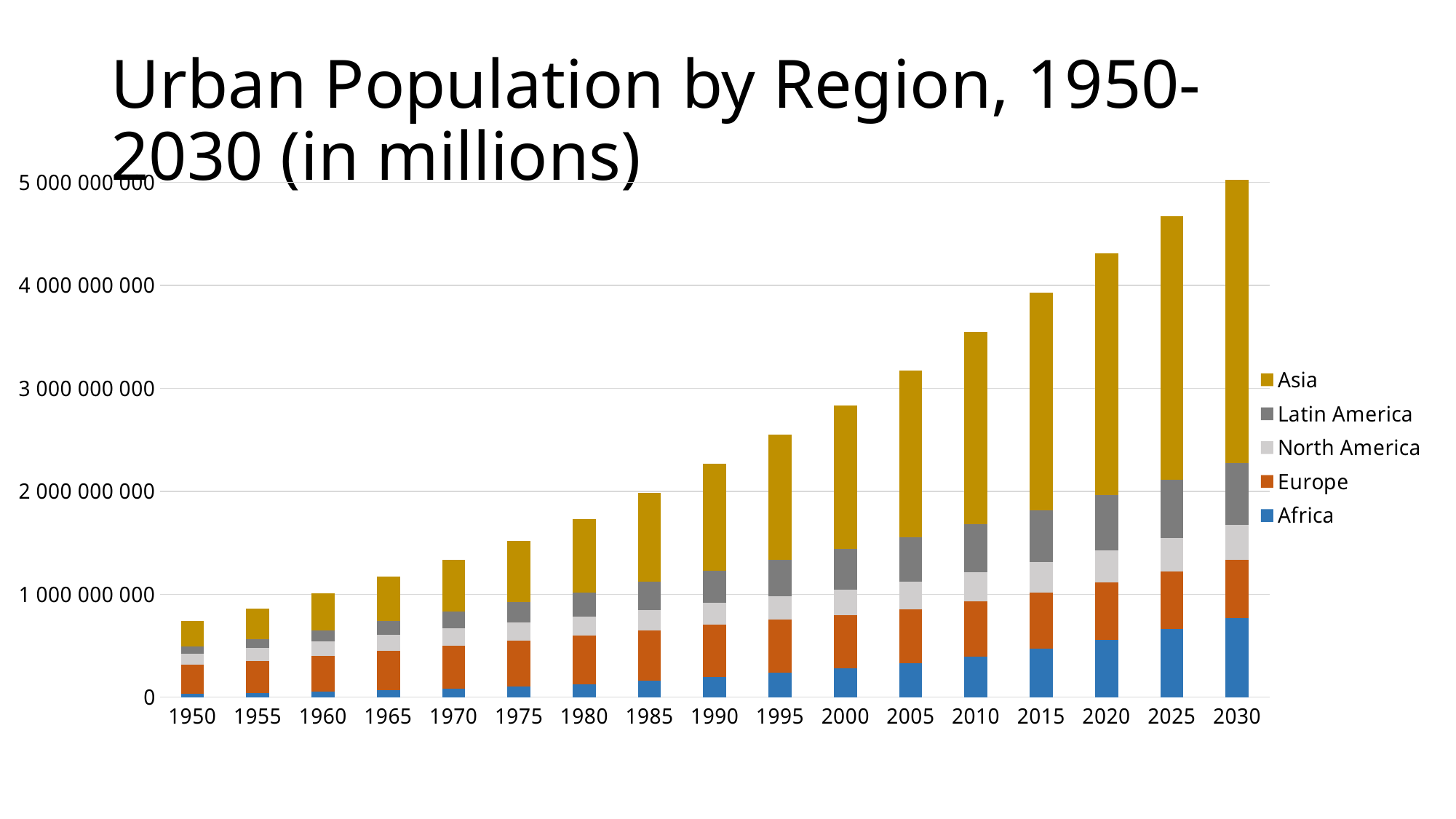
Is the total urban population for 1990 greater or less than 2 000 000 000? greater Which year has the lowest total urban population? 1950 Is the total urban population for 2025 greater or less than 4 000 000 000? greater How many series does the legend list? 5 Which year has the highest total urban population? 2030 What kind of chart is shown on the slide? stacked bar chart Do the total urban population values rise or fall from 1950 to 2030? rise Is the total urban population for 1955 greater or less than 1 000 000 000? less How many years are shown along the x axis? 17 Which region is shown by the topmost (gold) segment of each bar? Asia Which year has the larger total urban population, 2000 or 2020? 2020